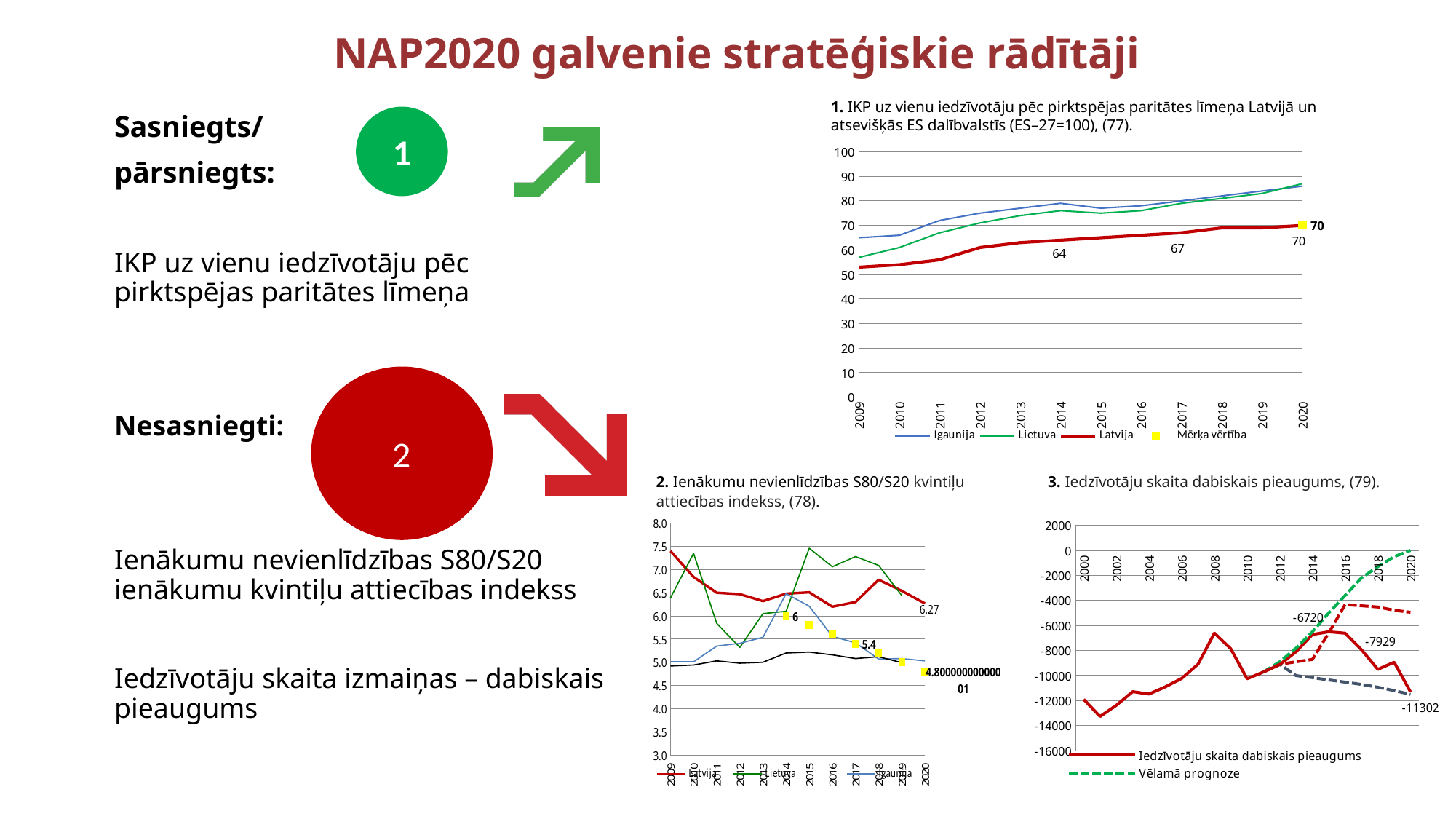
In the chart titled "IKP uz vienu iedzīvotāju pēc pirktspējas paritātes līmeņa...", what kind of chart is shown? line chart In the chart titled "IKP uz vienu iedzīvotāju pēc pirktspējas paritātes līmeņa...", is the value for Igaunija in 2020 greater or less than 80? greater In the chart titled "Iedzīvotāju skaita dabiskais pieaugums", how many series does the legend list? 2 In the chart titled "IKP uz vienu iedzīvotāju pēc pirktspējas paritātes līmeņa...", how many series does the legend list? 4 In the chart titled "Ienākumu nevienlīdzības S80/S20 kvintiļu attiecības indekss", what is the labelled target value (yellow marker) for 2017? 5.4 In the chart titled "IKP uz vienu iedzīvotāju pēc pirktspējas paritātes līmeņa...", which is higher in 2012, Igaunija or Latvija? Igaunija In the chart titled "IKP uz vienu iedzīvotāju pēc pirktspējas paritātes līmeņa...", what is the difference between the Latvija values labelled for 2020 and 2014? 6 In the chart titled "IKP uz vienu iedzīvotāju pēc pirktspējas paritātes līmeņa...", what is the labelled value for Latvija in 2014? 64 In the chart titled "Iedzīvotāju skaita dabiskais pieaugums", what is the labelled value of the solid red line in 2020? -11302 In the chart titled "Ienākumu nevienlīdzības S80/S20 kvintiļu attiecības indekss", what is the labelled value for Latvija in 2020? 6.27 In the chart titled "IKP uz vienu iedzīvotāju pēc pirktspējas paritātes līmeņa...", does the Latvija line rise or fall from 2009 to 2020? rises